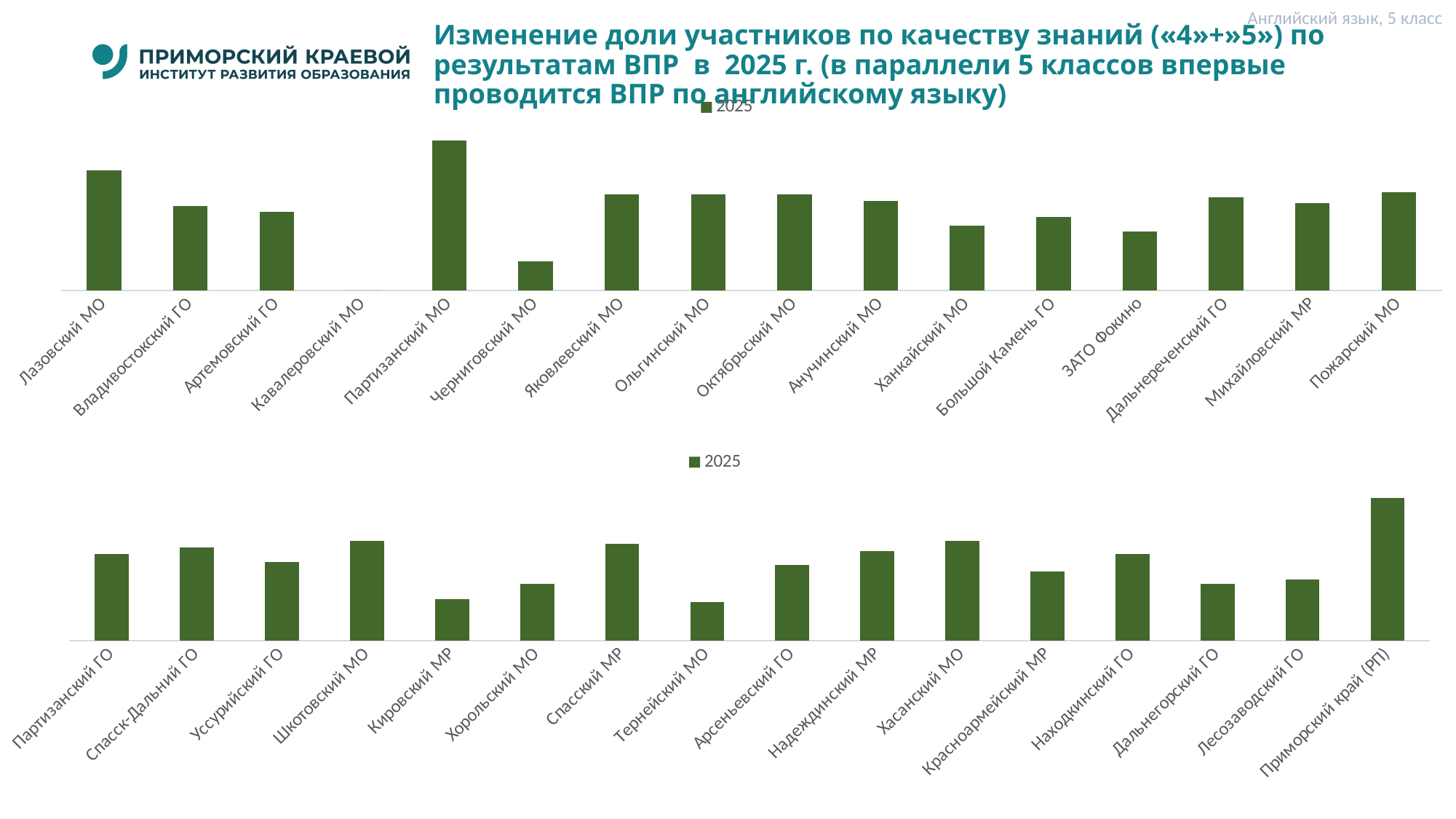
In the top chart, which category has the highest bar? Партизанский МО In the top chart, which is higher: Черниговский МО or Владивостокский ГО? Владивостокский ГО What is the legend entry shown for the bottom chart? 2025 What kind of chart is the top chart on the slide? bar chart In the top chart, which is higher: Партизанский МО or Лазовский МО? Партизанский МО How many categories are shown on the x axis of the top chart? 16 How many categories are shown on the x axis of the bottom chart? 16 In the bottom chart, which is higher: Шкотовский МО or Хорольский МО? Шкотовский МО In the bottom chart, which category has the highest bar? Приморский край (РП) How many series does the legend of the top chart list? 1 In the top chart, which category has no visible bar? Кавалеровский МО